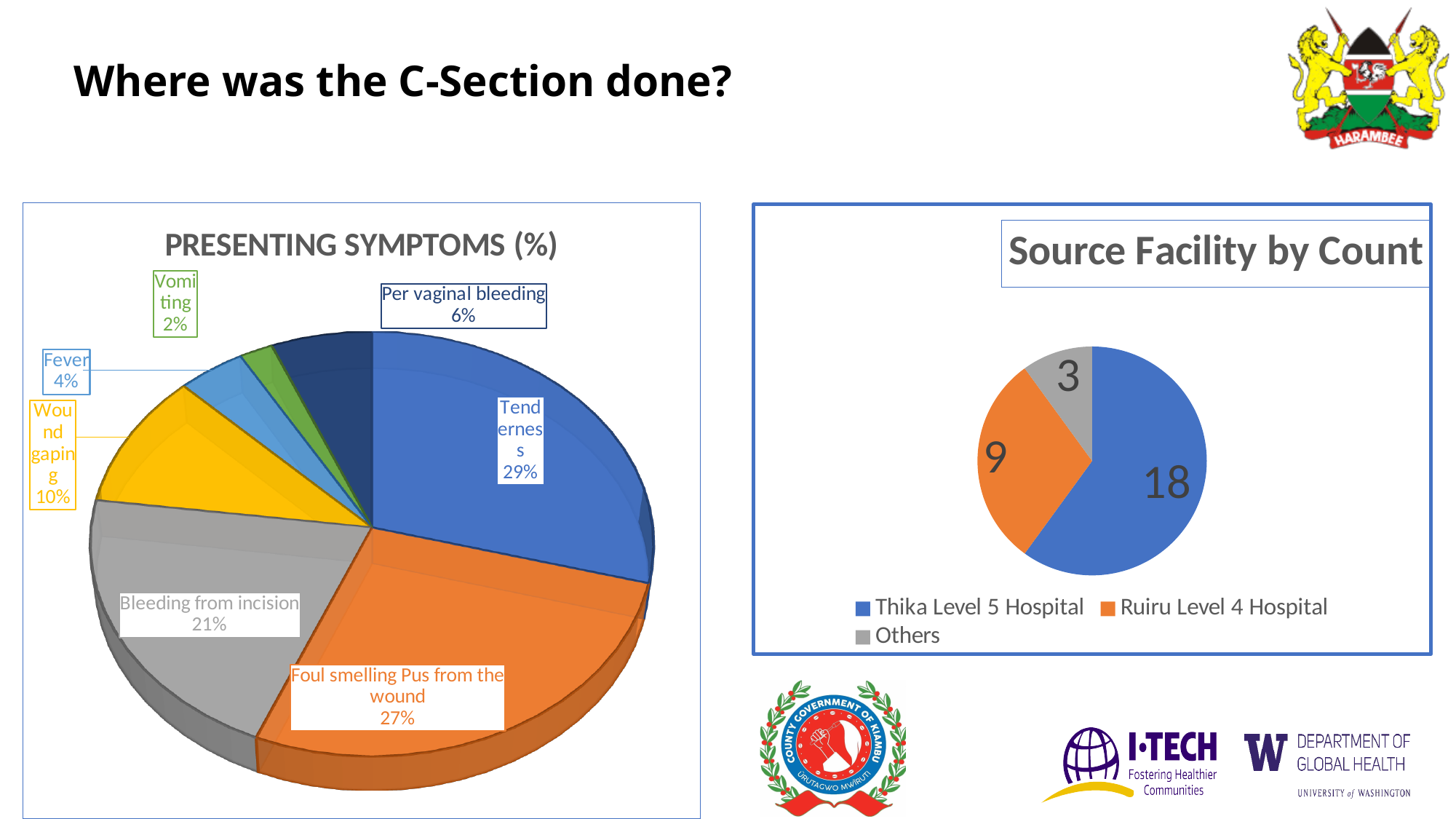
In the 'Presenting Symptoms (%)' chart, what is the difference in percentage points between Foul smelling Pus from the wound and Wound gaping? 17 In the 'Presenting Symptoms (%)' chart, how many symptom categories are shown? 7 In the 'Presenting Symptoms (%)' chart, which symptom has the largest share? Tenderness In the 'Presenting Symptoms (%)' chart, which symptom has the smallest share? Vomiting In the 'Source Facility by Count' chart, what share of the total does Thika Level 5 Hospital represent? 60% In the 'Source Facility by Count' chart, what is the count for Ruiru Level 4 Hospital? 9 In the 'Source Facility by Count' chart, which is larger: the count for Others or the count for Ruiru Level 4 Hospital? Ruiru Level 4 Hospital In the 'Presenting Symptoms (%)' chart, what percentage is shown for Tenderness? 29% In the 'Presenting Symptoms (%)' chart, what percentage is shown for Bleeding from incision? 21% In the 'Source Facility by Count' chart, what is the total count across all facilities? 30 What type of chart is 'Source Facility by Count'? Pie chart In the 'Source Facility by Count' chart, which facility has the highest count? Thika Level 5 Hospital